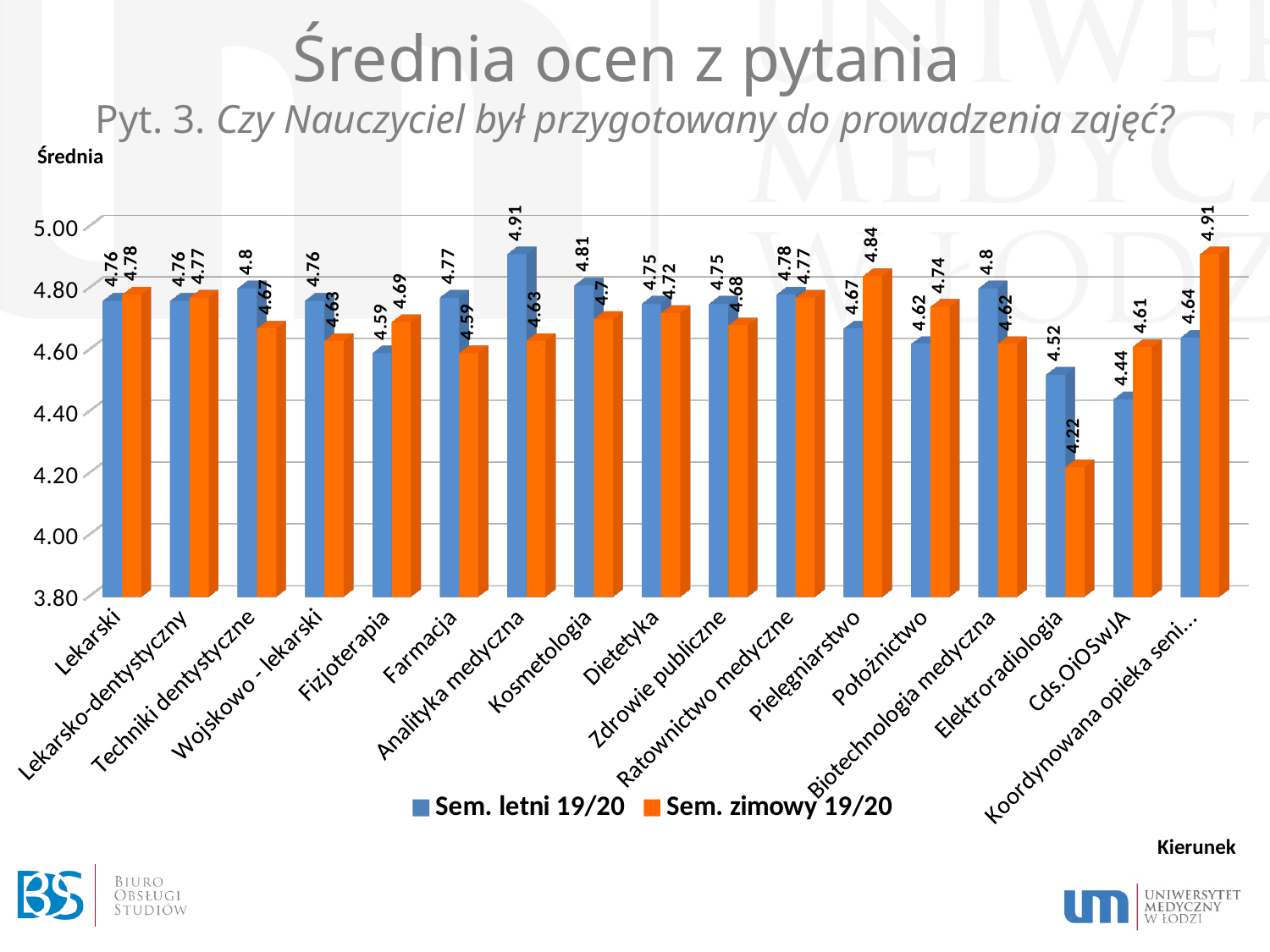
What kind of chart is shown on the slide? Bar chart What is the difference between the Sem. letni 19/20 and Sem. zimowy 19/20 values for Elektroradiologia? 0.3 How many categories are shown on the x axis? 17 What is the Sem. letni 19/20 value for Analityka medyczna? 4.91 Which category has the highest Sem. letni 19/20 value? Analityka medyczna What is the Sem. letni 19/20 value for Fizjoterapia? 4.59 What is the Sem. zimowy 19/20 value for Elektroradiologia? 4.22 Which category has the lowest Sem. zimowy 19/20 value? Elektroradiologia For Farmacja, which is larger: the Sem. letni 19/20 value or the Sem. zimowy 19/20 value? Sem. letni 19/20 Which category has the lowest Sem. letni 19/20 value? Cds.OiOSwJA What is the Sem. zimowy 19/20 value for Pielęgniarstwo? 4.84 How many series does the legend list? 2